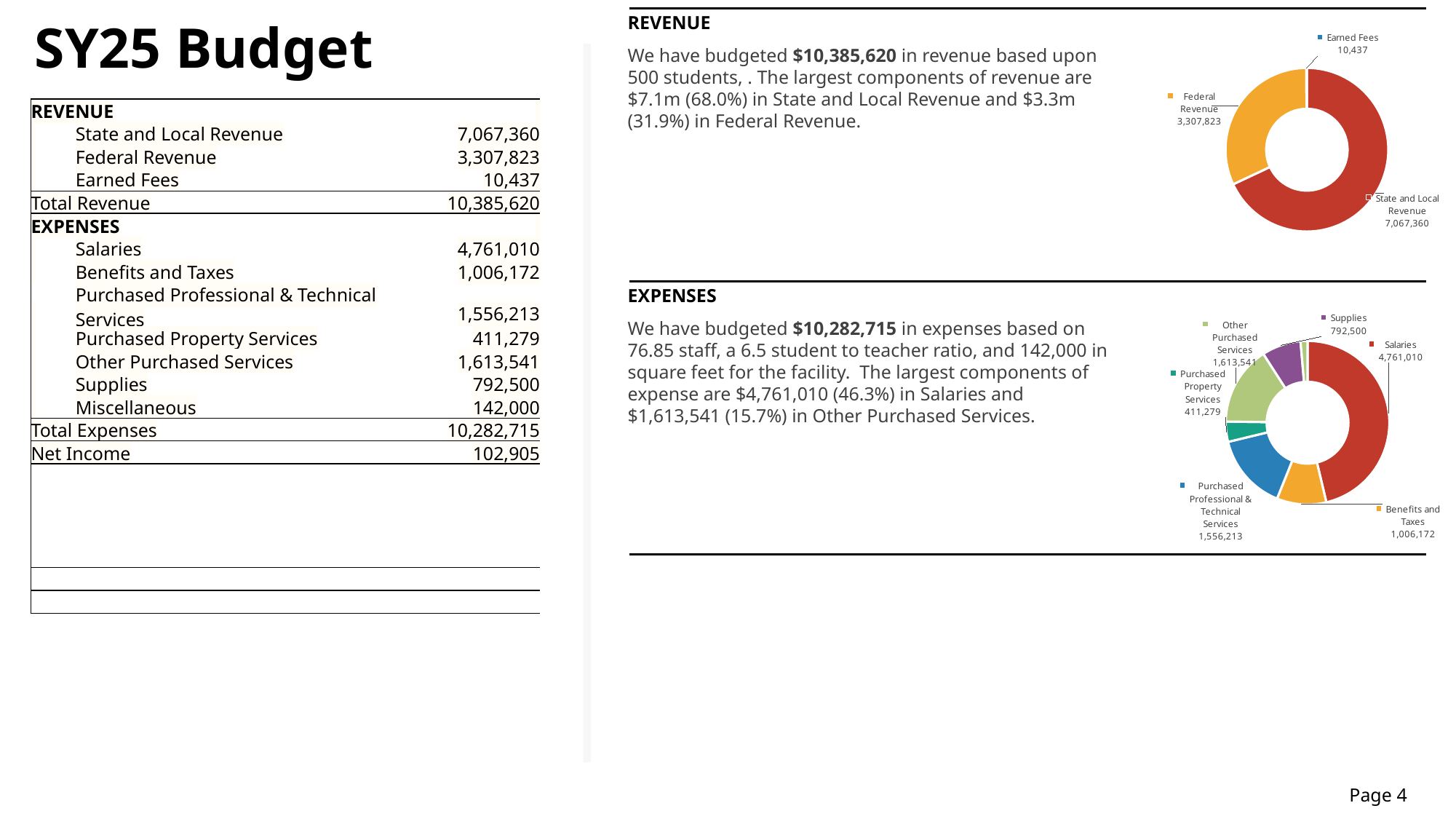
What kind of chart is the Revenue chart? donut chart In the Revenue chart, what is the value for Earned Fees? 10,437 In the Expenses chart, what is the value for Purchased Property Services? 411,279 In the Revenue chart, what is the difference between State and Local Revenue and Federal Revenue? 3,759,537 In the Expenses chart, which is larger, Supplies or Benefits and Taxes? Benefits and Taxes In the Expenses chart, what is the value for Salaries? 4,761,010 In the Revenue chart, which category has the smallest slice? Earned Fees How many categories are shown in the Revenue chart? 3 In the Expenses chart, which labeled category has the largest slice? Salaries In the Revenue chart, what is the value for Federal Revenue? 3,307,823 In the Revenue chart, which category has the largest slice? State and Local Revenue In the Expenses chart, what is the difference between Salaries and Other Purchased Services? 3,147,469